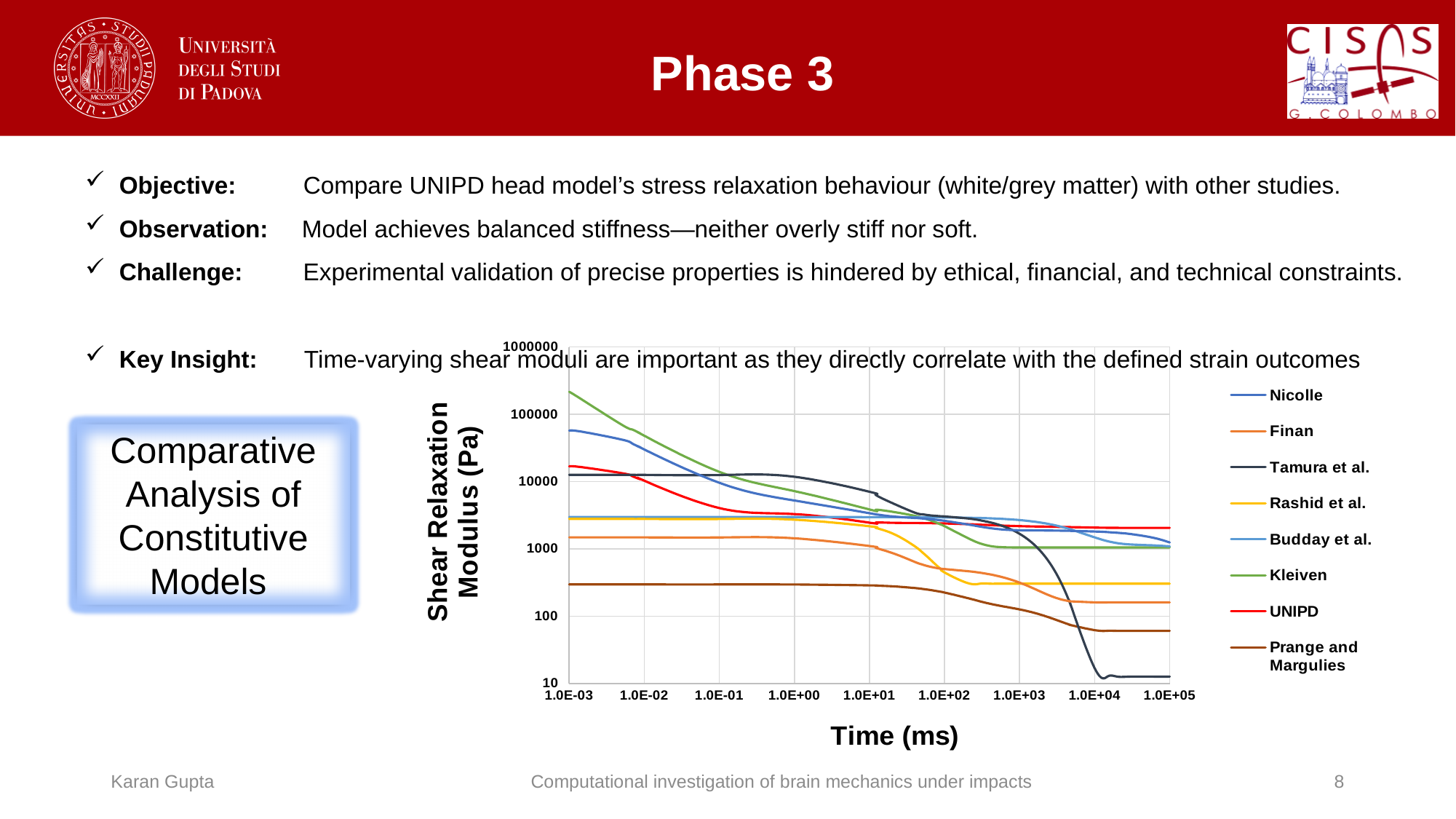
At 1.0E+05 ms, which series has the larger value, UNIPD or Finan? UNIPD Is the value for Tamura et al. at 1.0E+05 ms greater or less than 100? less How many series does the legend of the chart list? 8 Is the value for Kleiven at 1.0E-03 ms greater or less than 100000? greater Which series has the lowest shear relaxation modulus at 1.0E-03 ms? Prange and Margulies Does the Kleiven series rise or fall as time increases along the x axis? fall Which series has the highest shear relaxation modulus at 1.0E-03 ms? Kleiven Which series has the lowest shear relaxation modulus at 1.0E+05 ms? Tamura et al. Is the value for UNIPD at 1.0E+05 ms greater or less than 1000? greater What is the title of the vertical axis of the chart? Shear Relaxation Modulus (Pa) What is the title of the horizontal axis of the chart? Time (ms) What kind of chart is shown on the slide? line chart